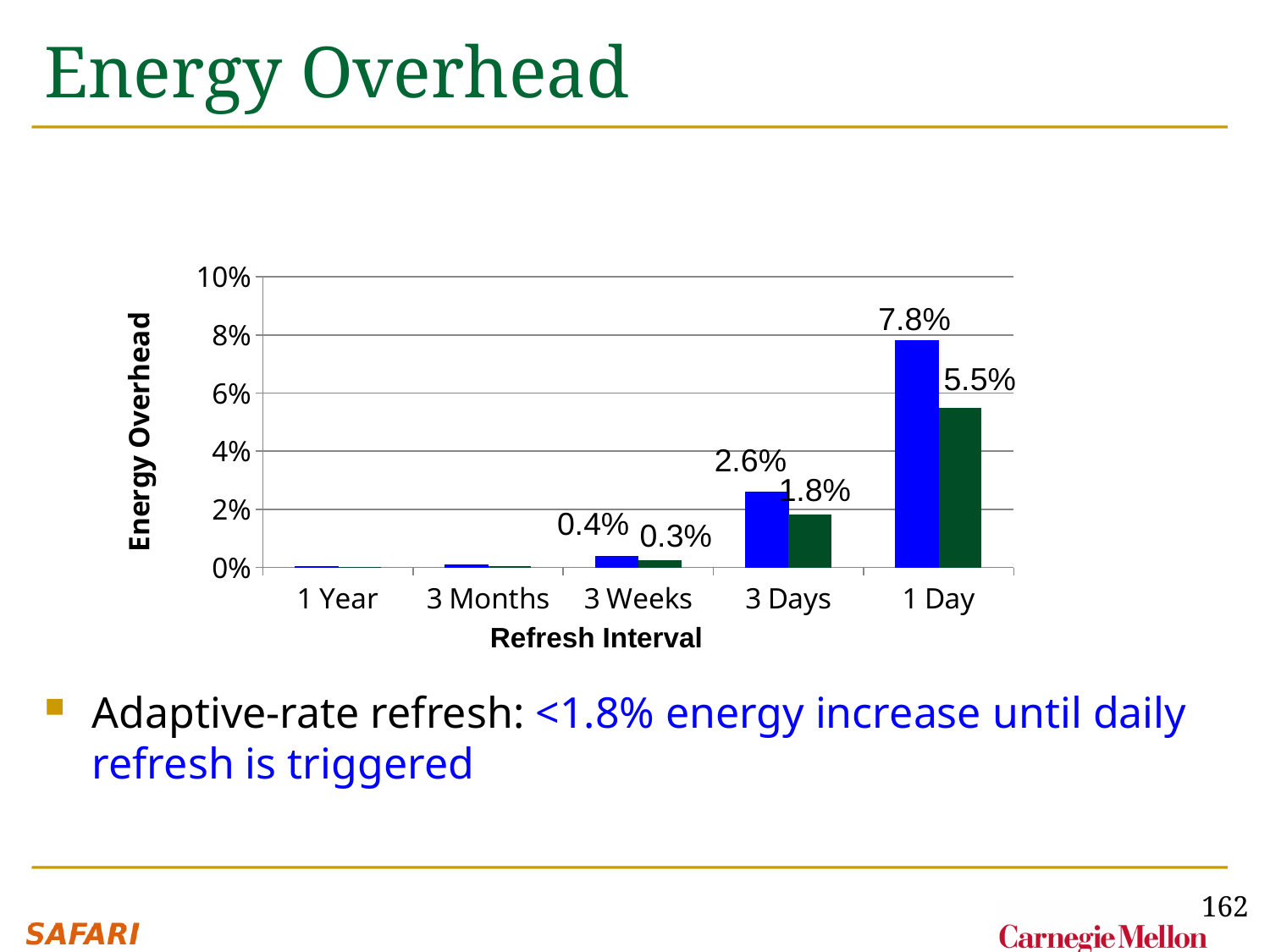
Is the blue bar for 1 Day greater or less than 6%? greater What is the value of the dark green bar for 1 Day? 5.5% What is the value of the blue bar for 3 Days? 2.6% What is the difference between the blue bars for 1 Day and 3 Days? 5.2% What kind of chart is shown on the slide? bar chart For 3 Days, which bar is larger, the blue or the dark green? blue How many refresh intervals are shown on the x axis? 5 Which refresh interval has the highest energy overhead for the blue bars? 1 Day What is the label of the x axis? Refresh Interval What is the value of the blue bar for 1 Day? 7.8% What is the value of the dark green bar for 3 Weeks? 0.3% What is the difference between the blue and dark green bars for 1 Day? 2.3%